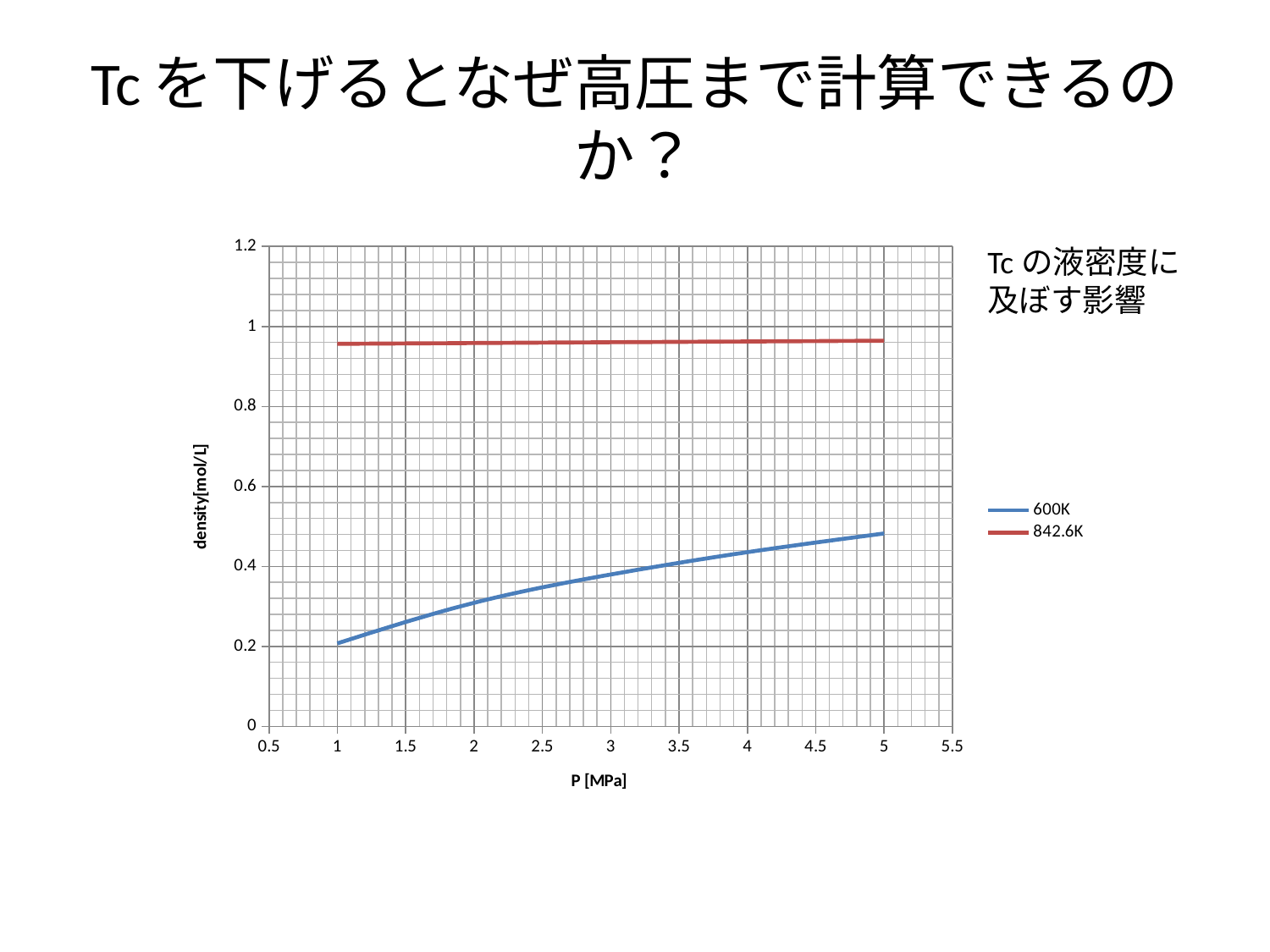
Does the density for the 600K series rise or fall as P increases? rise What is the label of the x axis of the chart? P [MPa] Which series has the lower density across the plotted pressure range? 600K Which series has the higher density at P = 3 MPa, 600K or 842.6K? 842.6K Is the density for the 600K series at P = 1 MPa greater or less than 0.4? less What kind of chart is shown on the slide? line chart Is the density for the 600K series at P = 5 MPa greater or less than 0.4? greater Is the density for the 842.6K series at P = 3 MPa greater or less than 0.8? greater What are the two series named in the chart legend? 600K and 842.6K How many series does the chart legend list? 2